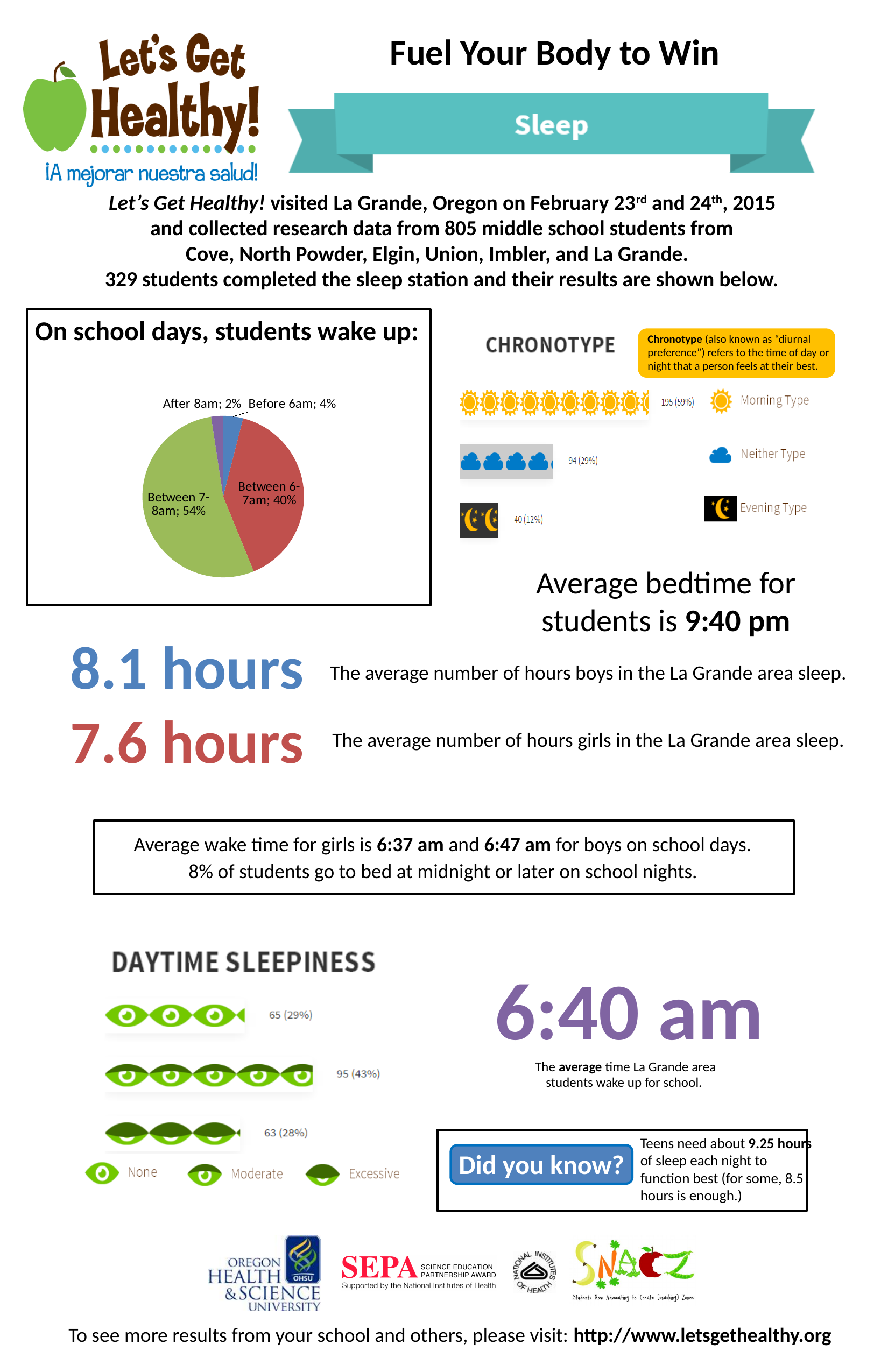
In the Daytime Sleepiness chart, how many students reported moderate daytime sleepiness? 95 (43%) In the Chronotype chart, which chronotype has the fewest students? Evening Type In the Chronotype chart, what is the difference between the number of Morning Type and Neither Type students? 101 What type of chart is used for 'On school days, students wake up'? Pie chart In the 'On school days, students wake up' pie chart, what is the difference in percentage points between the 'Between 7-8am' and 'Between 6-7am' slices? 14 percentage points In the 'On school days, students wake up' pie chart, which wake-up time category has the smallest share? After 8am In the 'On school days, students wake up' pie chart, what percentage of students wake up before 6am? 4% In the 'On school days, students wake up' pie chart, how many slices are there? 4 In the 'On school days, students wake up' pie chart, what percentage of students wake up between 7-8am? 54% In the Daytime Sleepiness chart, which is larger: the number of students with no daytime sleepiness or with excessive daytime sleepiness? None In the Chronotype chart, how many students are Morning Type? 195 (59%) In the 'On school days, students wake up' pie chart, which wake-up time category has the largest share? Between 7-8am